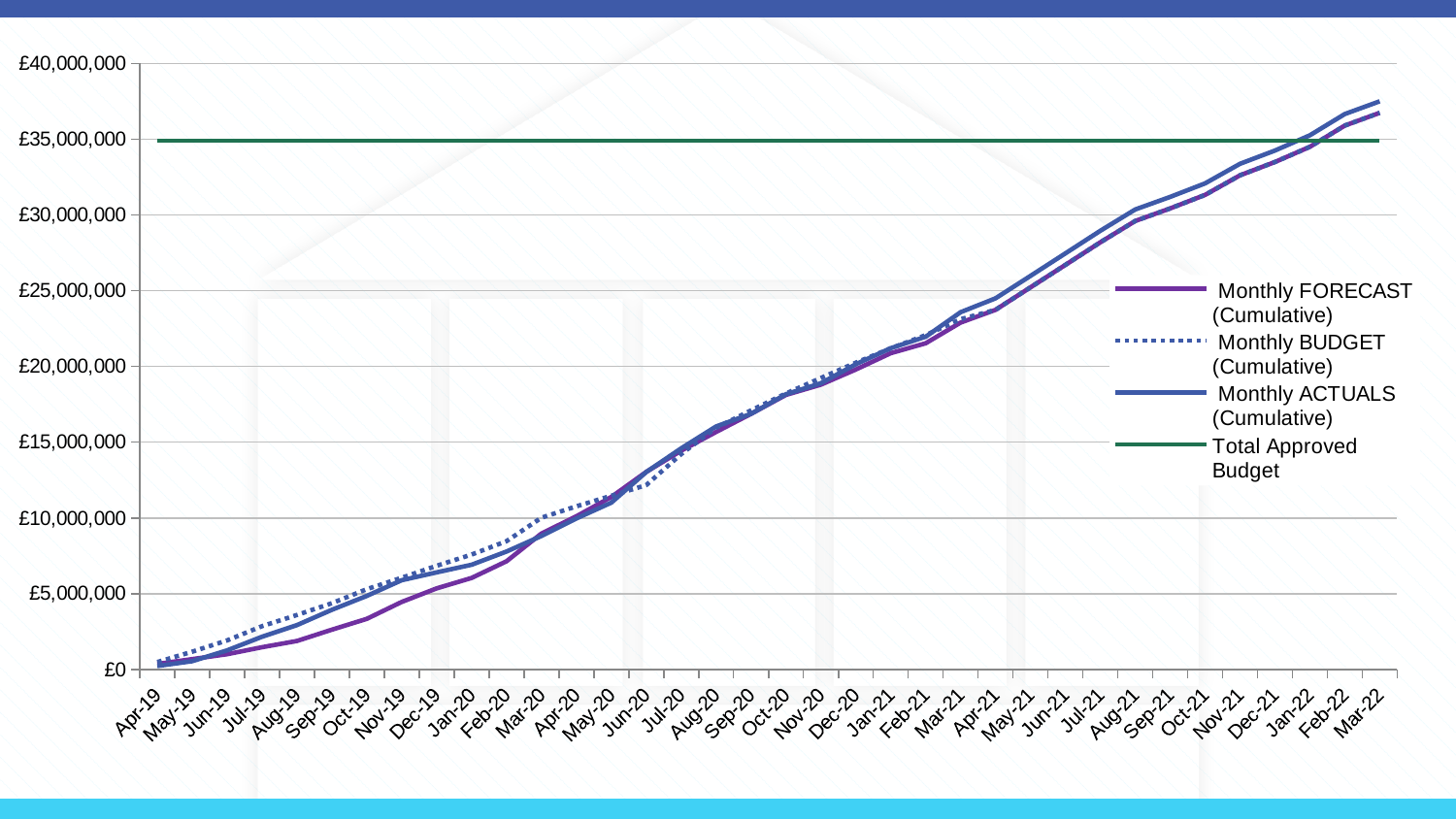
Is the Monthly BUDGET (Cumulative) value at Dec-19 greater or less than £5,000,000? greater Is the Monthly FORECAST (Cumulative) value at Aug-19 greater or less than £5,000,000? less At Mar-22, which is higher: Monthly ACTUALS (Cumulative) or Monthly FORECAST (Cumulative)? Monthly ACTUALS (Cumulative) At Dec-19, which is higher: Monthly BUDGET (Cumulative) or Monthly FORECAST (Cumulative)? Monthly BUDGET (Cumulative) What kind of chart is shown on the slide? line chart Do the Monthly ACTUALS (Cumulative) values rise or fall from Apr-19 to Mar-22? rise Is the Monthly ACTUALS (Cumulative) value at Mar-22 greater or less than £35,000,000? greater Which series is drawn as a dotted line? Monthly BUDGET (Cumulative) How many series does the legend list? 4 How many months are shown along the x axis? 36